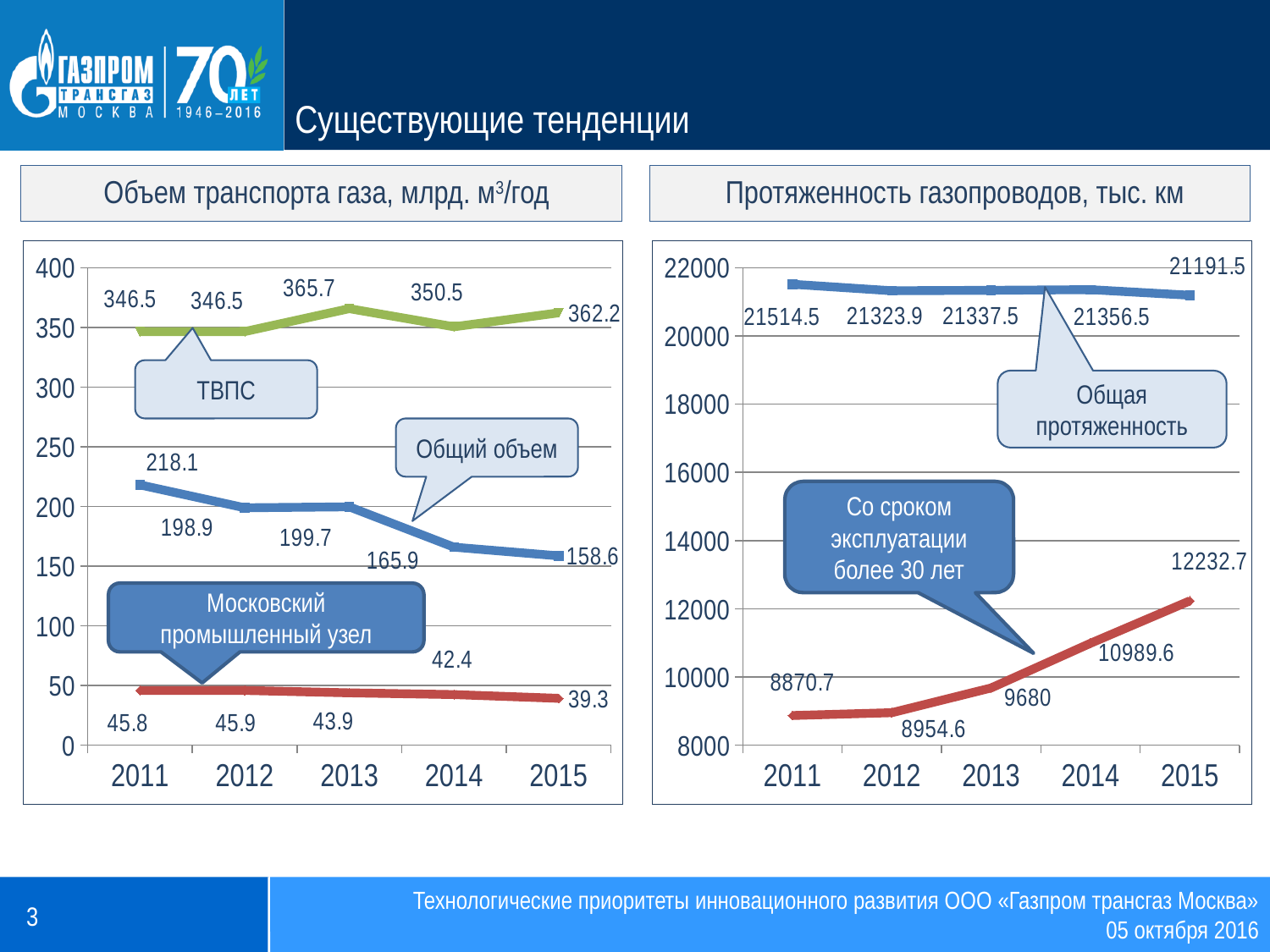
In the chart 'Протяженность газопроводов, тыс. км', is the value for 'Со сроком эксплуатации более 30 лет' in 2015 greater or less than 12000? greater In the chart 'Протяженность газопроводов, тыс. км', does the series 'Со сроком эксплуатации более 30 лет' rise or fall from 2011 to 2015? rise In the chart 'Протяженность газопроводов, тыс. км', what is the value for 'Со сроком эксплуатации более 30 лет' in 2013? 9680 In the chart 'Объем транспорта газа, млрд. м3/год', how many years are shown on the x axis? 5 In the chart 'Объем транспорта газа, млрд. м3/год', does the Общий объем series rise or fall from 2011 to 2015? fall In the chart 'Протяженность газопроводов, тыс. км', in which year is the value for 'Со сроком эксплуатации более 30 лет' highest? 2015 In the chart 'Объем транспорта газа, млрд. м3/год', what is the value for ТВПС in 2013? 365.7 In the chart 'Объем транспорта газа, млрд. м3/год', what is the difference between the Общий объем values for 2011 and 2015? 59.5 What kind of chart is 'Протяженность газопроводов, тыс. км'? line chart In the chart 'Протяженность газопроводов, тыс. км', what is the value for Общая протяженность in 2011? 21514.5 In the chart 'Объем транспорта газа, млрд. м3/год', what is the value for Общий объем in 2015? 158.6 In the chart 'Объем транспорта газа, млрд. м3/год', in which year is the value for Московский промышленный узел lowest? 2015